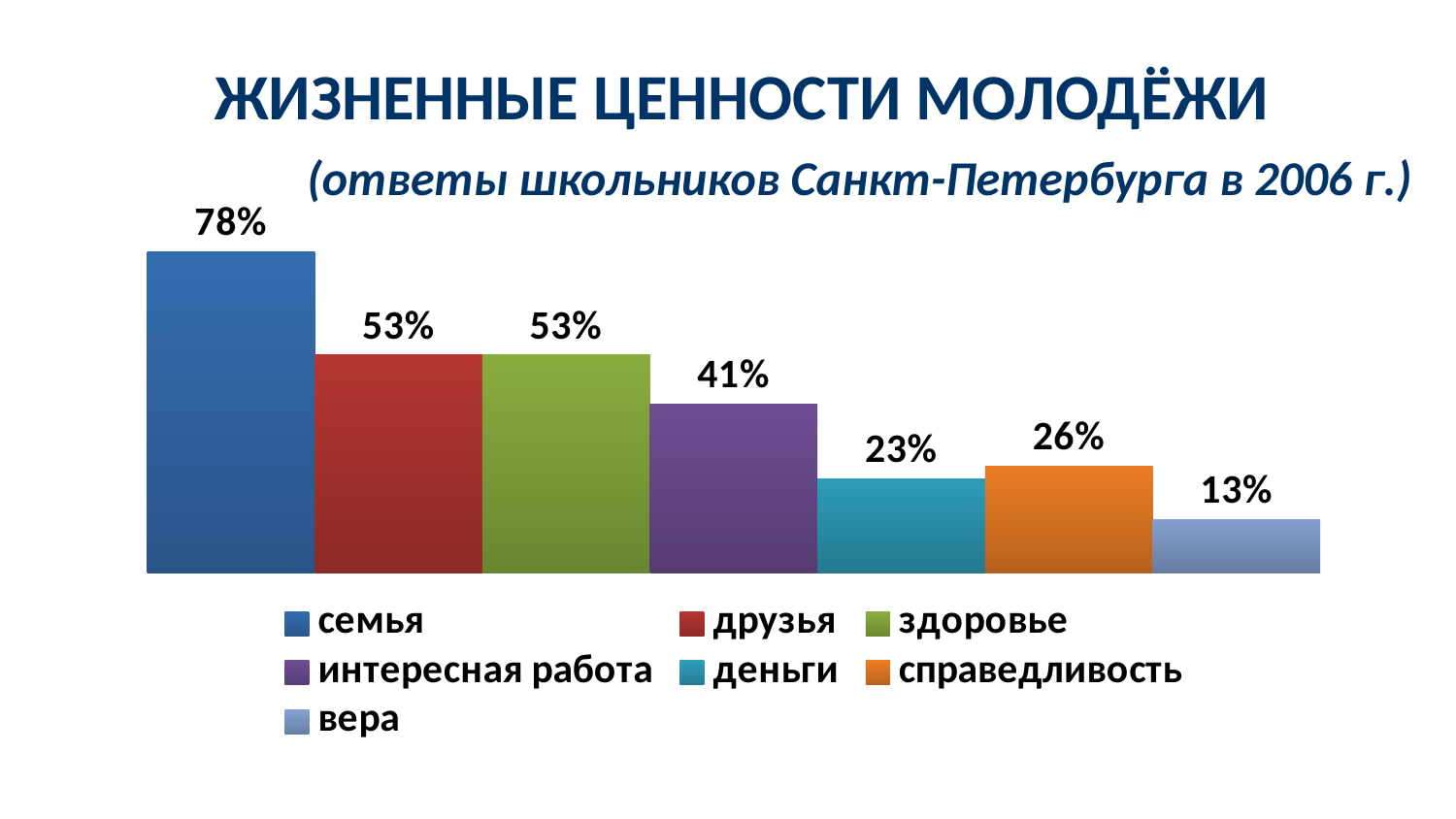
What is the value for семья? 78% What colour is the bar for здоровье? green What kind of chart is shown on the slide? bar chart How many series does the legend list? 7 Which is larger, the value for справедливость or the value for деньги? справедливость What is the value for справедливость? 26% What is the difference between the values for друзья and интересная работа? 12% Which category has the lowest value? вера What is the difference between the values for семья and вера? 65% What is the value for деньги? 23% What is the value for интересная работа? 41% Which category has the highest value? семья